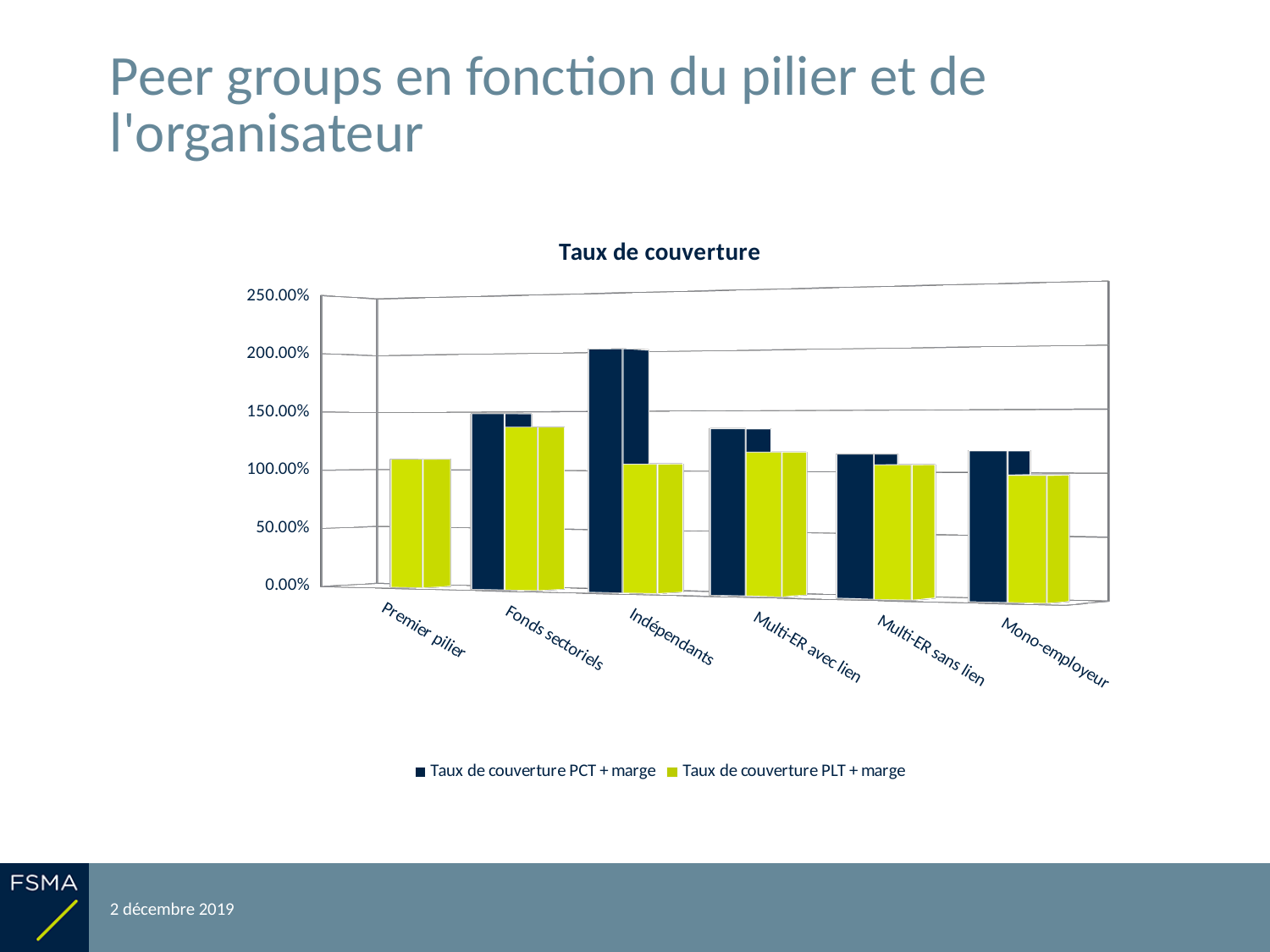
Is the value of Taux de couverture PLT + marge for Indépendants greater or less than 150.00%? less Which category has the highest value for Taux de couverture PCT + marge? Indépendants What is the title of the chart? Taux de couverture How many series does the legend list? 2 Which is larger: Taux de couverture PCT + marge for Fonds sectoriels or for Mono-employeur? Fonds sectoriels What kind of chart is shown on the slide? bar chart Which colour represents Taux de couverture PCT + marge in the chart? dark navy blue Is the value of Taux de couverture PCT + marge for Indépendants greater or less than 150.00%? greater Is the value of Taux de couverture PCT + marge for Multi-ER avec lien greater or less than 100.00%? greater For Indépendants, which is larger: Taux de couverture PCT + marge or Taux de couverture PLT + marge? Taux de couverture PCT + marge How many categories are shown on the x axis of the chart? 6